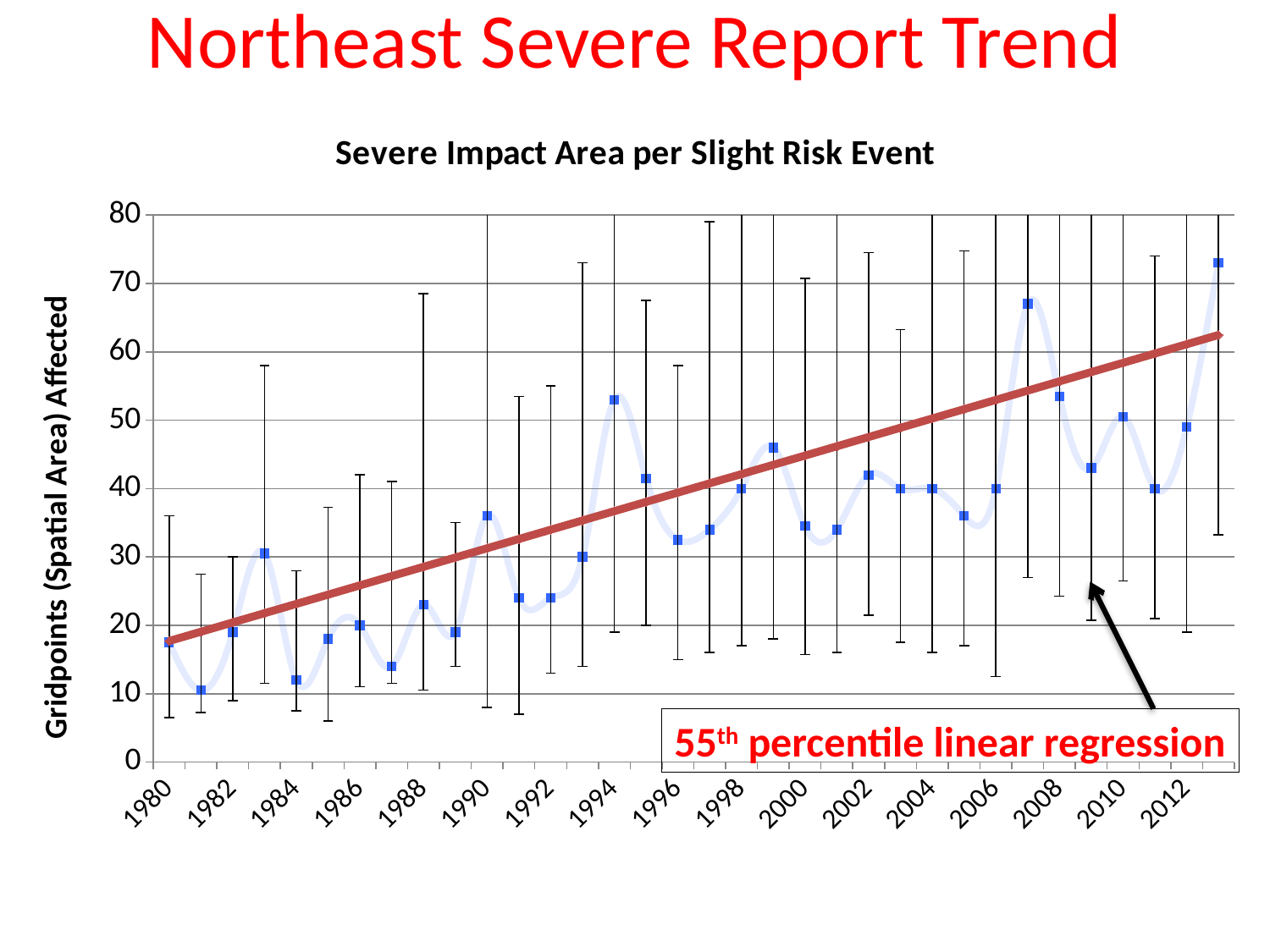
Is the value for 1984 greater or less than 20? less Which year has the larger plotted value, 1994 or 1995? 1994 Is the value for 1981 greater or less than 20? less Which year has the larger plotted value, 2007 or 2008? 2007 Is the value for 2007 greater or less than 60? greater What is the title of the chart? Severe Impact Area per Slight Risk Event What does the red line on the chart represent? 55th percentile linear regression What kind of chart is shown on the slide? line chart Does the red regression line rise or fall from 1980 to 2013? rise Which year has the highest plotted value? 2013